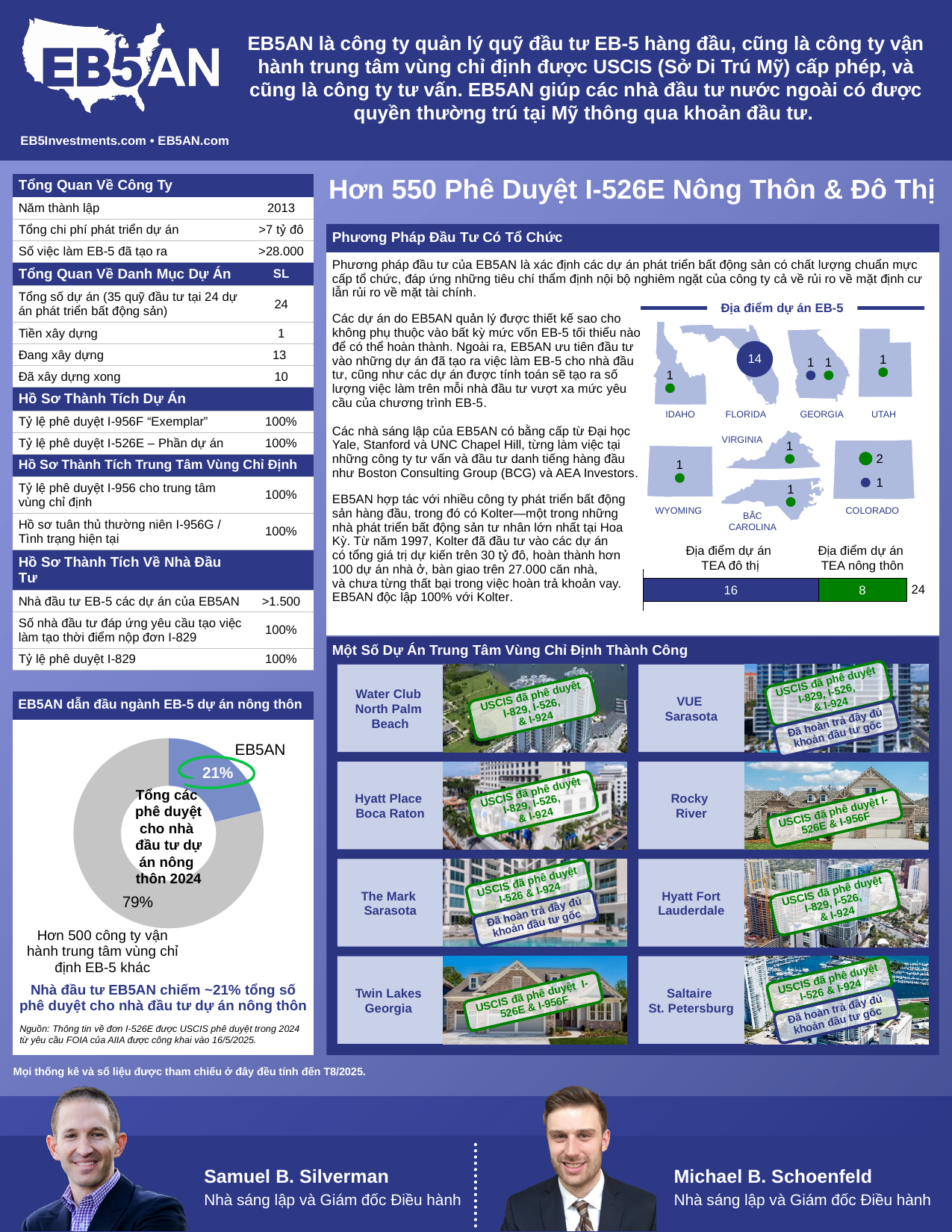
In the donut chart 'EB5AN dẫn đầu ngành EB-5 dự án nông thôn', what is the difference in percentage points between the two slices? 58 In the donut chart 'EB5AN dẫn đầu ngành EB-5 dự án nông thôn', which slice is larger: EB5AN or the other regional center operators? The other regional center operators In the stacked bar below the 'Địa điểm dự án EB-5' map, how many projects are in rural TEA locations (Địa điểm dự án TEA nông thôn)? 8 In the donut chart 'EB5AN dẫn đầu ngành EB-5 dự án nông thôn', what share of rural project investor approvals in 2024 is attributed to EB5AN? 21% In the donut chart 'EB5AN dẫn đầu ngành EB-5 dự án nông thôn', what share is attributed to the more than 500 other EB-5 regional center operators? 79% In the stacked bar below the 'Địa điểm dự án EB-5' map, what is the total number of projects across urban and rural TEA locations? 24 In the stacked bar below the 'Địa điểm dự án EB-5' map, what colour is the rural TEA (TEA nông thôn) segment? Green In the stacked bar below the 'Địa điểm dự án EB-5' map, what is the difference between the urban TEA and rural TEA project counts? 8 In the stacked bar below the 'Địa điểm dự án EB-5' map, which segment is larger: urban TEA or rural TEA? Urban TEA (TEA đô thị) How many slices does the donut chart 'EB5AN dẫn đầu ngành EB-5 dự án nông thôn' have? 2 What type of chart is used under the heading 'EB5AN dẫn đầu ngành EB-5 dự án nông thôn'? Donut (pie) chart In the stacked bar below the 'Địa điểm dự án EB-5' map, how many projects are in urban TEA locations (Địa điểm dự án TEA đô thị)? 16